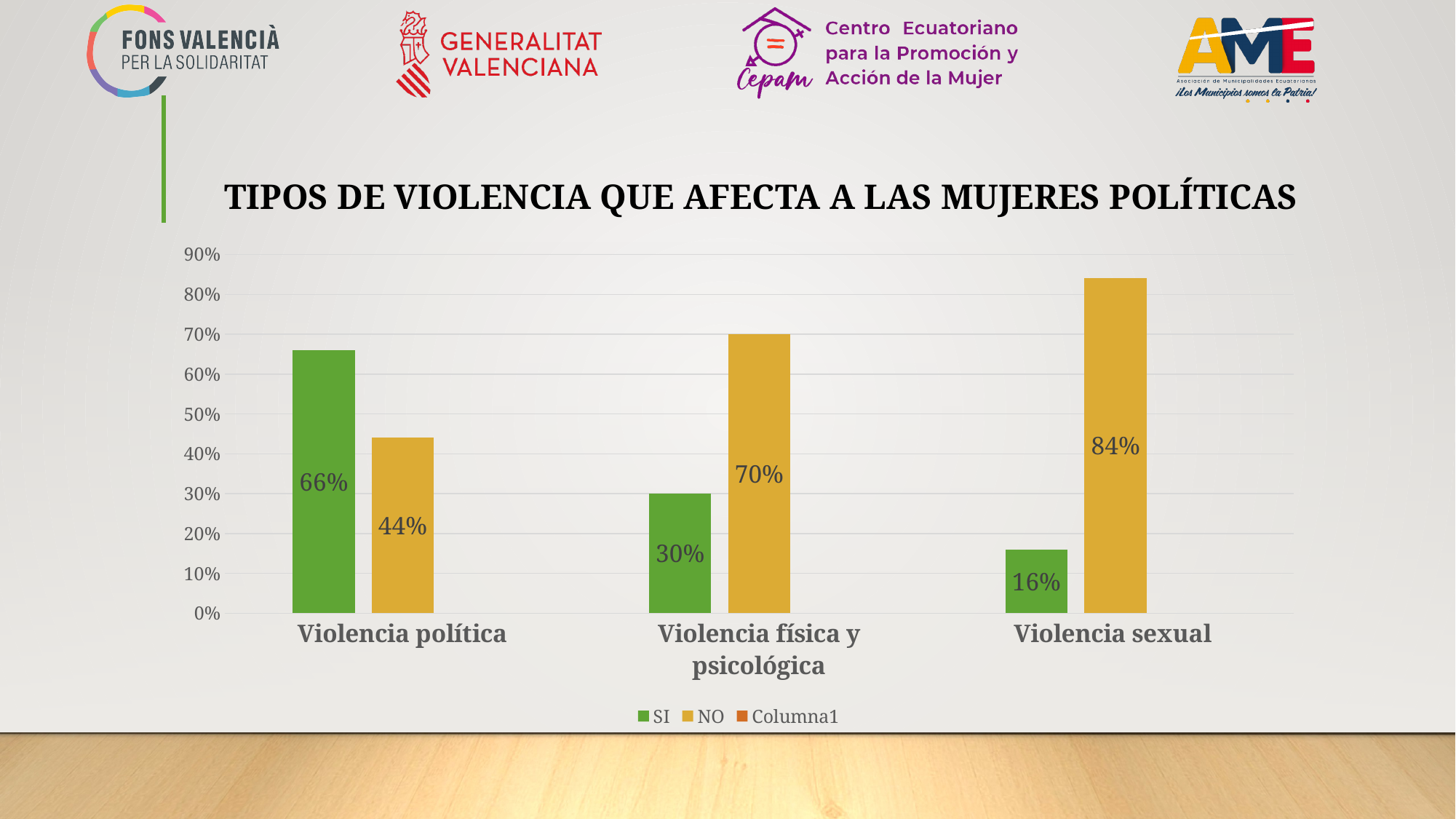
What is the difference between the NO and SI values for Violencia física y psicológica? 40% What is the title of the chart? TIPOS DE VIOLENCIA QUE AFECTA A LAS MUJERES POLÍTICAS Which category has the lowest SI value? Violencia sexual How many series does the legend list? 3 What kind of chart is shown on the slide? bar chart How many categories are shown on the x axis? 3 What is the NO value for Violencia sexual? 84% What is the SI value for Violencia física y psicológica? 30% Is the NO value for Violencia política greater or less than 50%? less Which category has the highest NO value? Violencia sexual Which is larger for Violencia política, the SI value or the NO value? SI What is the SI value for Violencia política? 66%